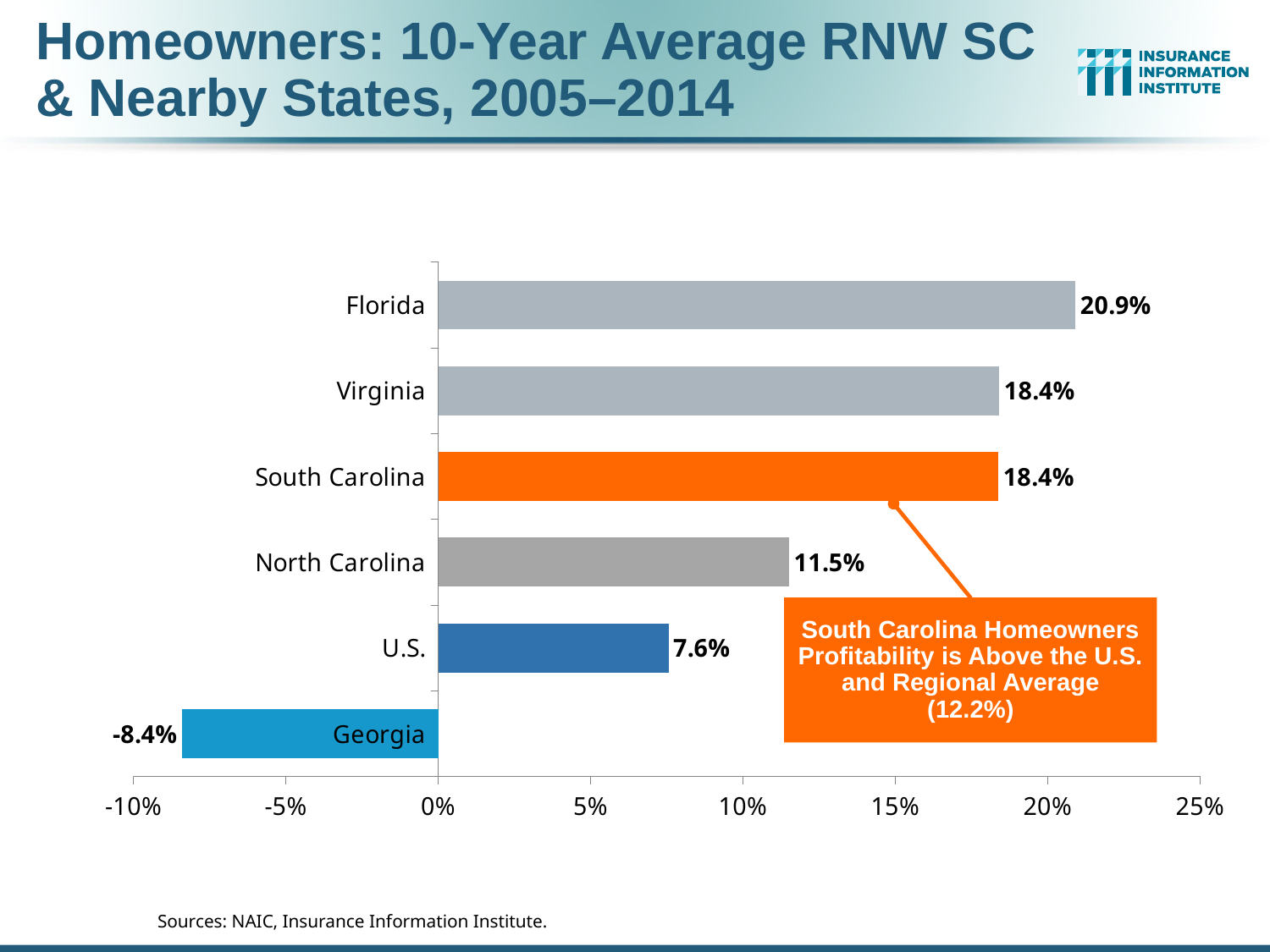
How many categories are shown in the chart? 6 According to the callout box, what is the regional average homeowners profitability? 12.2% What is the 10-year average RNW for the U.S.? 7.6% Which category has the highest 10-year average RNW? Florida What is the 10-year average RNW for Florida? 20.9% What kind of chart is shown on the slide? Bar chart What is the 10-year average RNW for Georgia? -8.4% Which category has the lowest 10-year average RNW? Georgia What is the 10-year average RNW for North Carolina? 11.5% Which has a higher 10-year average RNW, North Carolina or the U.S.? North Carolina What is the difference between South Carolina's and the U.S. 10-year average RNW? 10.8% What is the difference between Florida's and South Carolina's 10-year average RNW? 2.5%